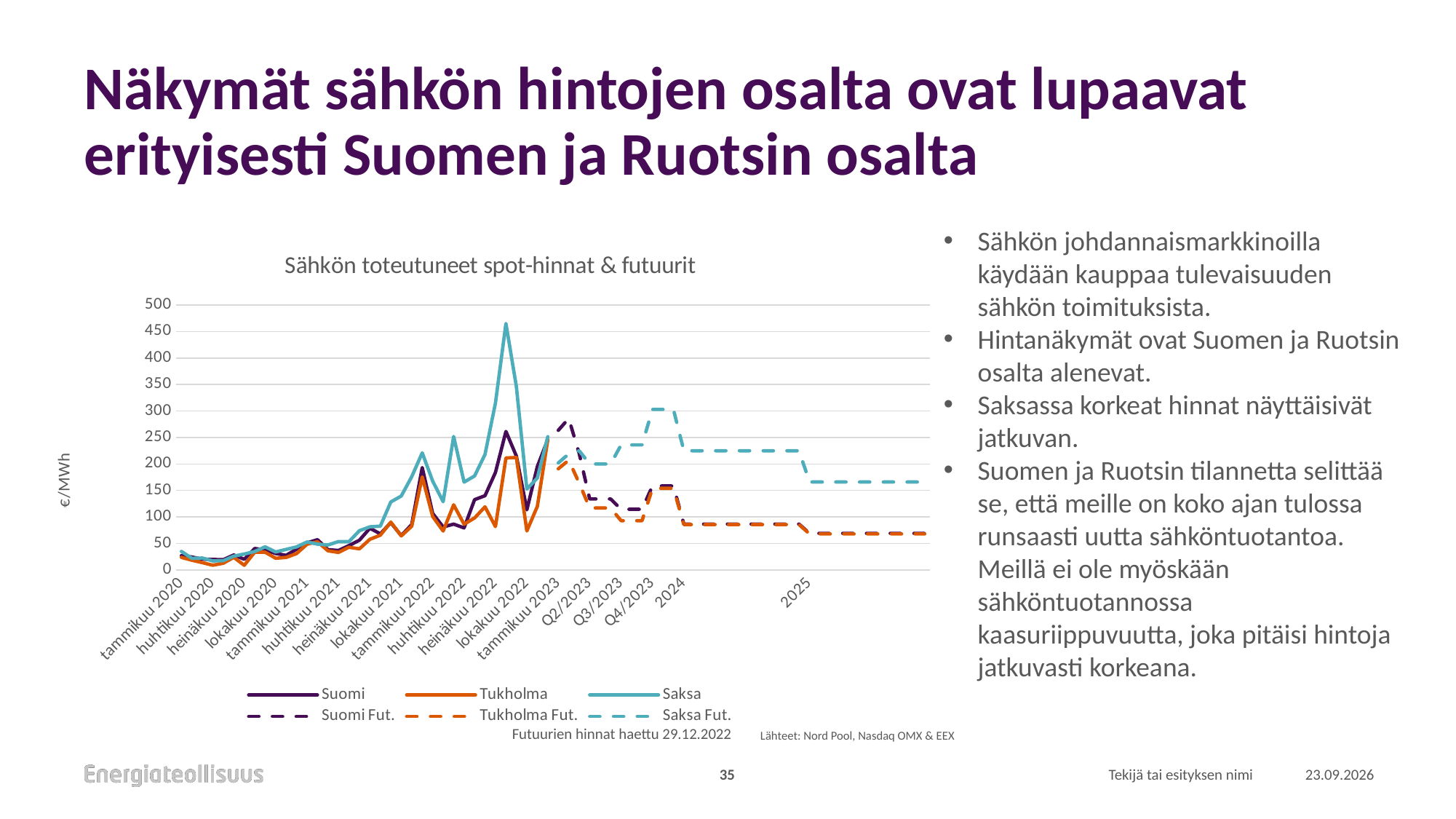
Does the Saksa Fut. series rise or fall from Q4/2023 to 2025? fall In 2025, which is higher: the Saksa Fut. series or the Suomi Fut. series? Saksa Fut. What is the title of the chart? Sähkön toteutuneet spot-hinnat & futuurit What kind of chart is shown on the slide? line chart Is the value of the Suomi Fut. series in 2025 greater or less than 100? less What unit is shown on the vertical axis label of the chart? €/MWh Is the peak value of the Saksa series greater or less than 400? greater Which series reaches the highest value on the chart? Saksa Does the Saksa series rise or fall from tammikuu 2020 to heinäkuu 2022? rise Is the value of the Saksa Fut. series at Q4/2023 greater or less than 250? greater How many series does the chart legend list? 6